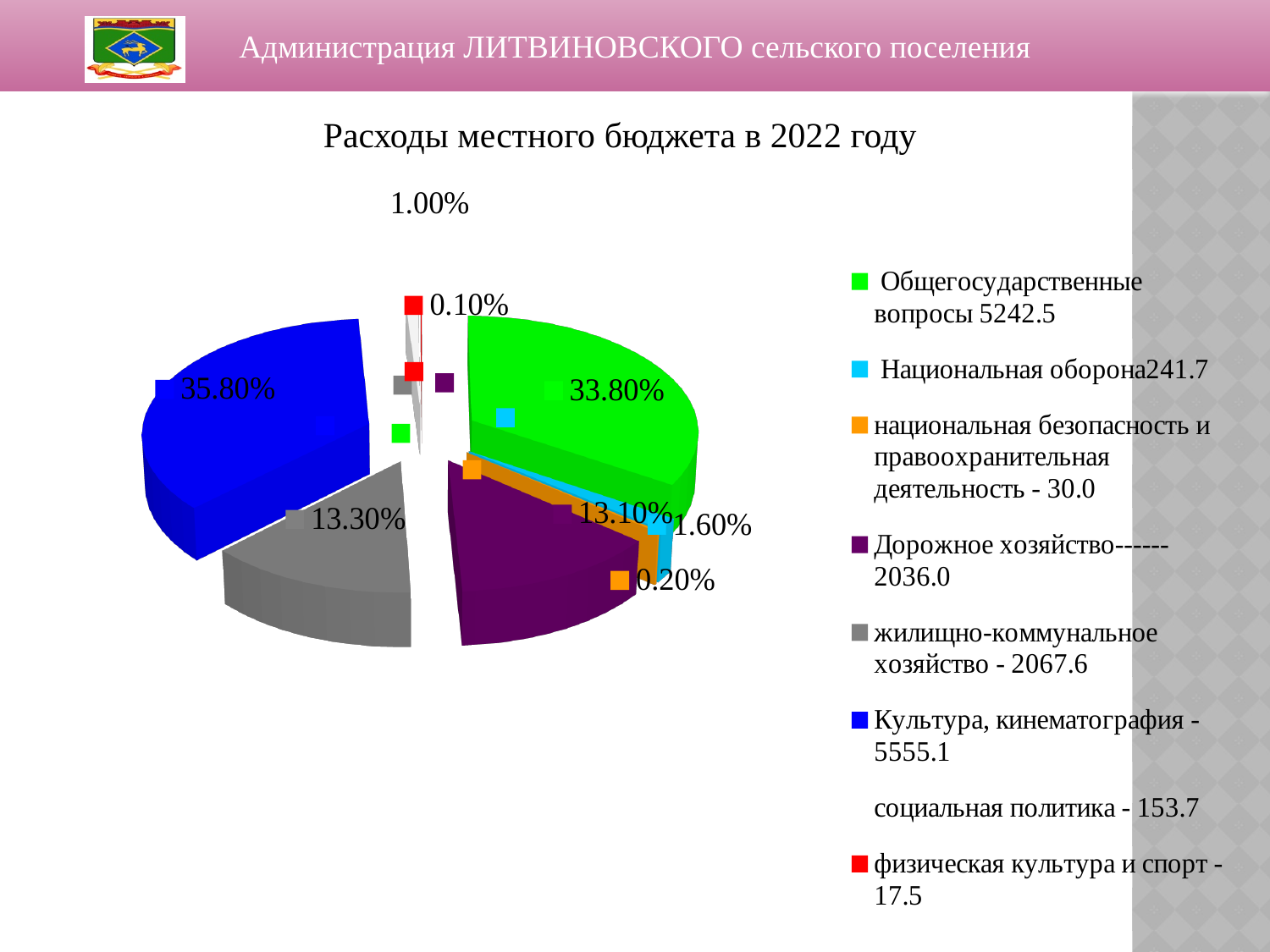
What kind of chart is shown on the slide? pie chart What share of the pie does жилищно-коммунальное хозяйство have? 13.30% What amount is shown in the legend for Дорожное хозяйство? 2036.0 Which category has the smallest slice of the pie? физическая культура и спорт What is the difference in percentage points between the Культура, кинематография slice and the Общегосударственные вопросы slice? 2.00% What share of the pie does Дорожное хозяйство have? 13.10% What is the title of the chart? Расходы местного бюджета в 2022 году How many categories does the legend of the pie chart list? 8 What share of the pie does Общегосударственные вопросы have? 33.80% Which category has the largest slice of the pie? Культура, кинематография